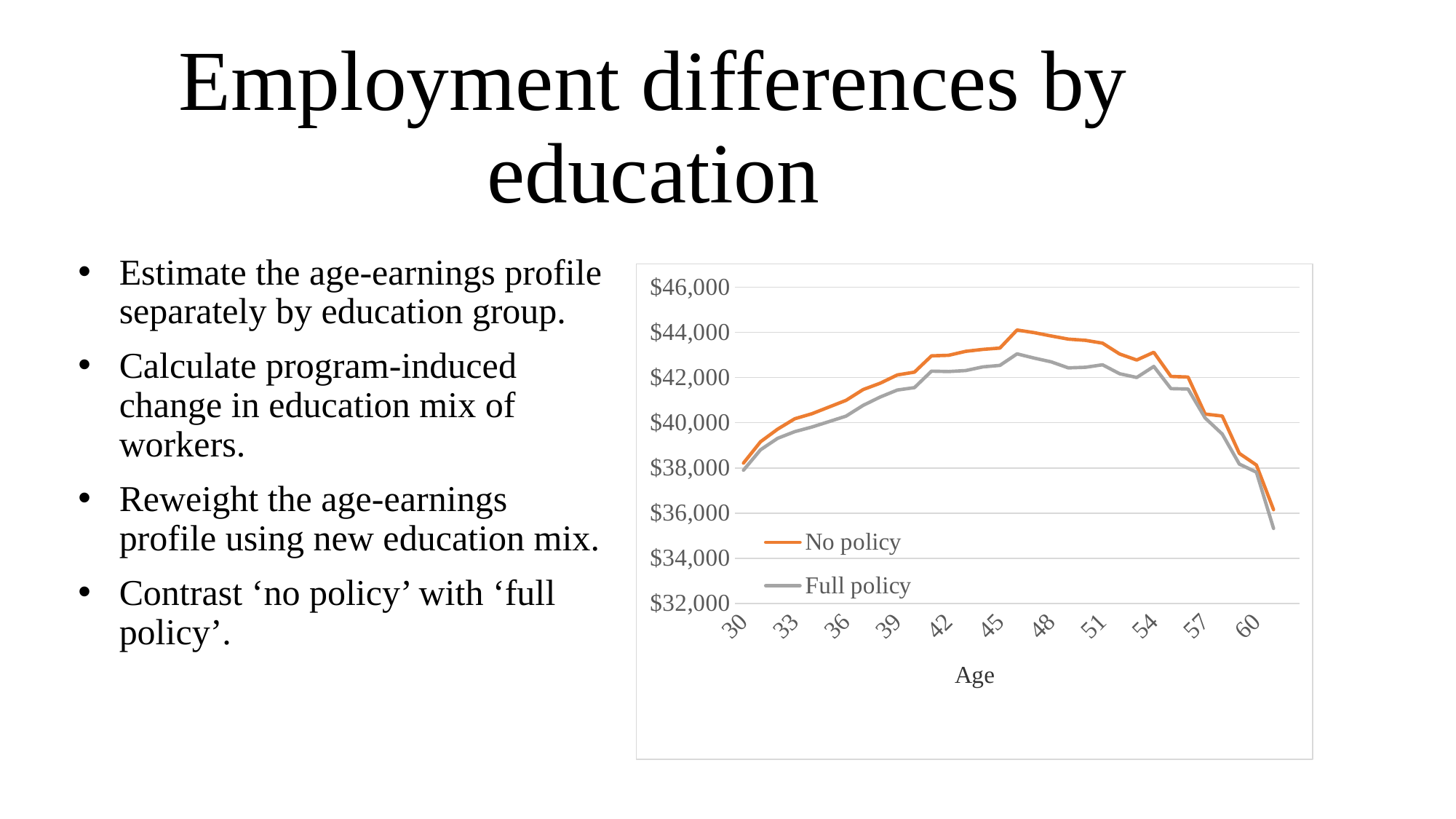
What kind of chart is shown on the slide? line chart What are the two series named in the chart's legend? No policy and Full policy Do the No policy values rise or fall between age 30 and age 45? rise Is the highest No policy value greater or less than $46,000? less Is the No policy value at age 45 greater or less than $42,000? greater How many age labels are printed on the x axis? 11 Is the Full policy value at age 33 greater or less than $40,000? less What is the title of the chart's x axis? Age How many series does the chart's legend list? 2 Do the Full policy values rise or fall between age 54 and the end of the series? fall At age 45, which series is higher, No policy or Full policy? No policy